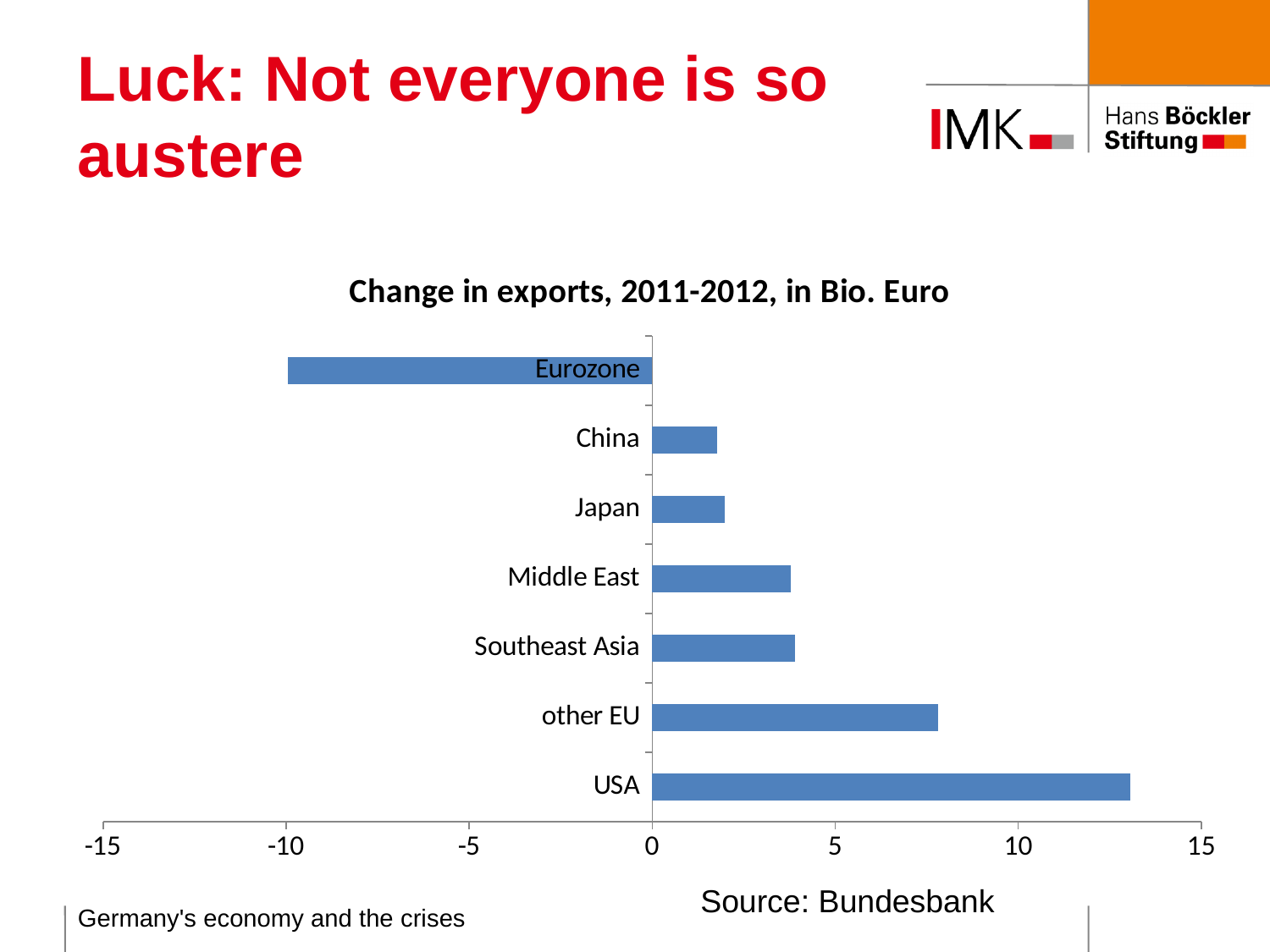
Is the value for China greater or less than 5? less Which has the larger change in exports, USA or other EU? USA What kind of chart is shown on the slide? Bar chart Which category shows the largest change in exports? USA What is the title of the chart? Change in exports, 2011-2012, in Bio. Euro Is the value for other EU greater or less than 10? less How many categories show a negative change in exports? 1 Is the value for other EU greater or less than 5? greater How many categories (regions/countries) are plotted in the chart? 7 Which has the larger change in exports, Eurozone or China? China Which category shows the lowest change in exports? Eurozone